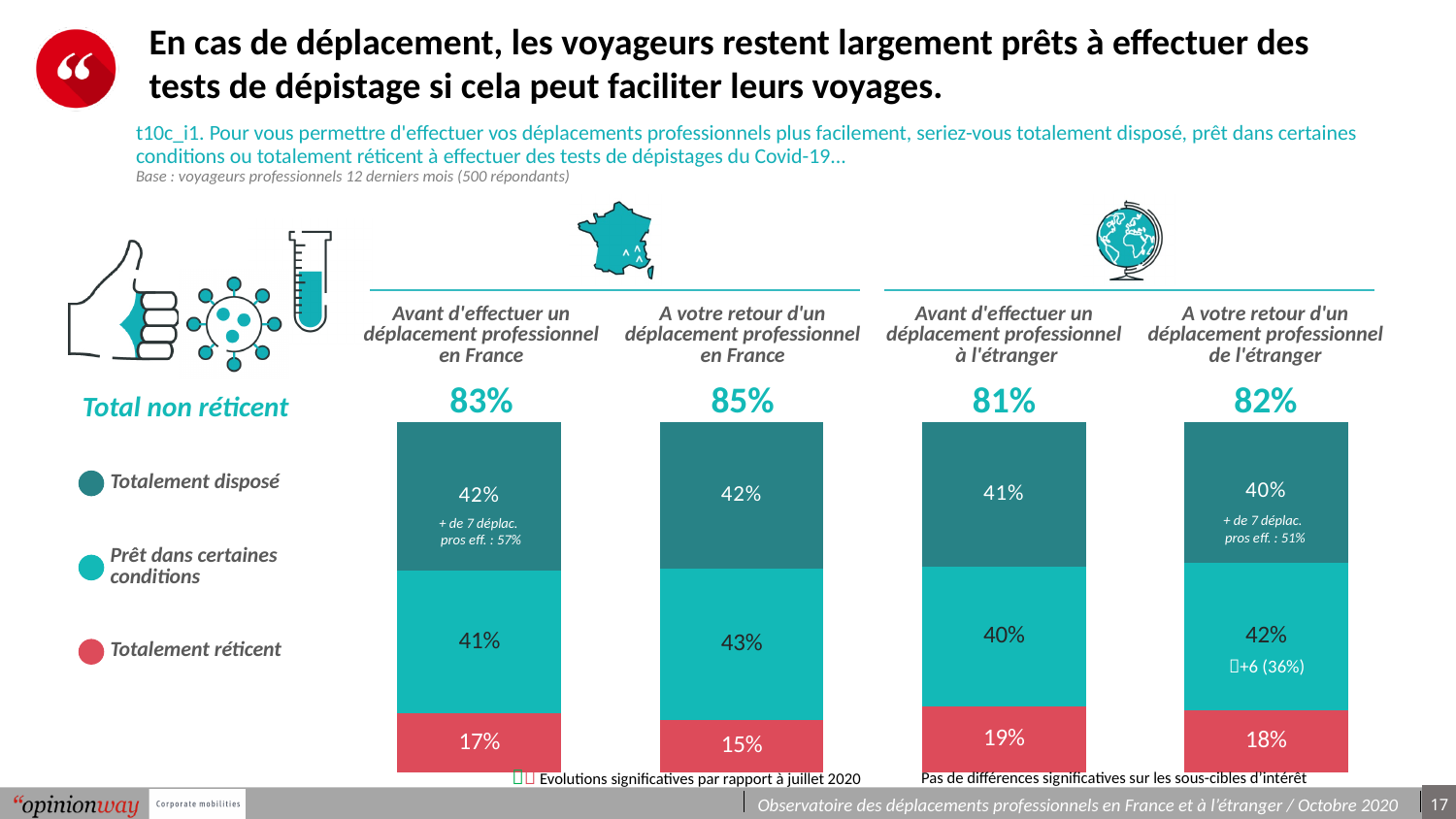
How many situations (bars) are shown in the chart? 4 Which situation has the highest 'Totalement réticent' share? Avant d'effectuer un déplacement professionnel à l'étranger What is the difference in 'Totalement réticent' share between 'Avant d'effectuer un déplacement professionnel à l'étranger' and 'A votre retour d'un déplacement professionnel en France'? 4 points Which of the four situations has the highest 'Total non réticent' value? A votre retour d'un déplacement professionnel en France What is the 'Total non réticent' value for 'A votre retour d'un déplacement professionnel en France'? 85% What percentage of respondents are 'Prêt dans certaines conditions' for 'Avant d'effectuer un déplacement professionnel à l'étranger'? 40% What percentage of respondents are 'Totalement disposé' for 'A votre retour d'un déplacement professionnel de l'étranger'? 40% Is the 'Prêt dans certaines conditions' share larger for 'A votre retour d'un déplacement professionnel en France' or for 'Avant d'effectuer un déplacement professionnel en France'? A votre retour d'un déplacement professionnel en France What percentage of respondents are 'Totalement réticent' before a professional trip in France ('Avant d'effectuer un déplacement professionnel en France')? 17% What kind of chart is shown on the slide? Stacked bar chart Which of the four situations has the lowest 'Total non réticent' value? Avant d'effectuer un déplacement professionnel à l'étranger How many series does the legend list? 3